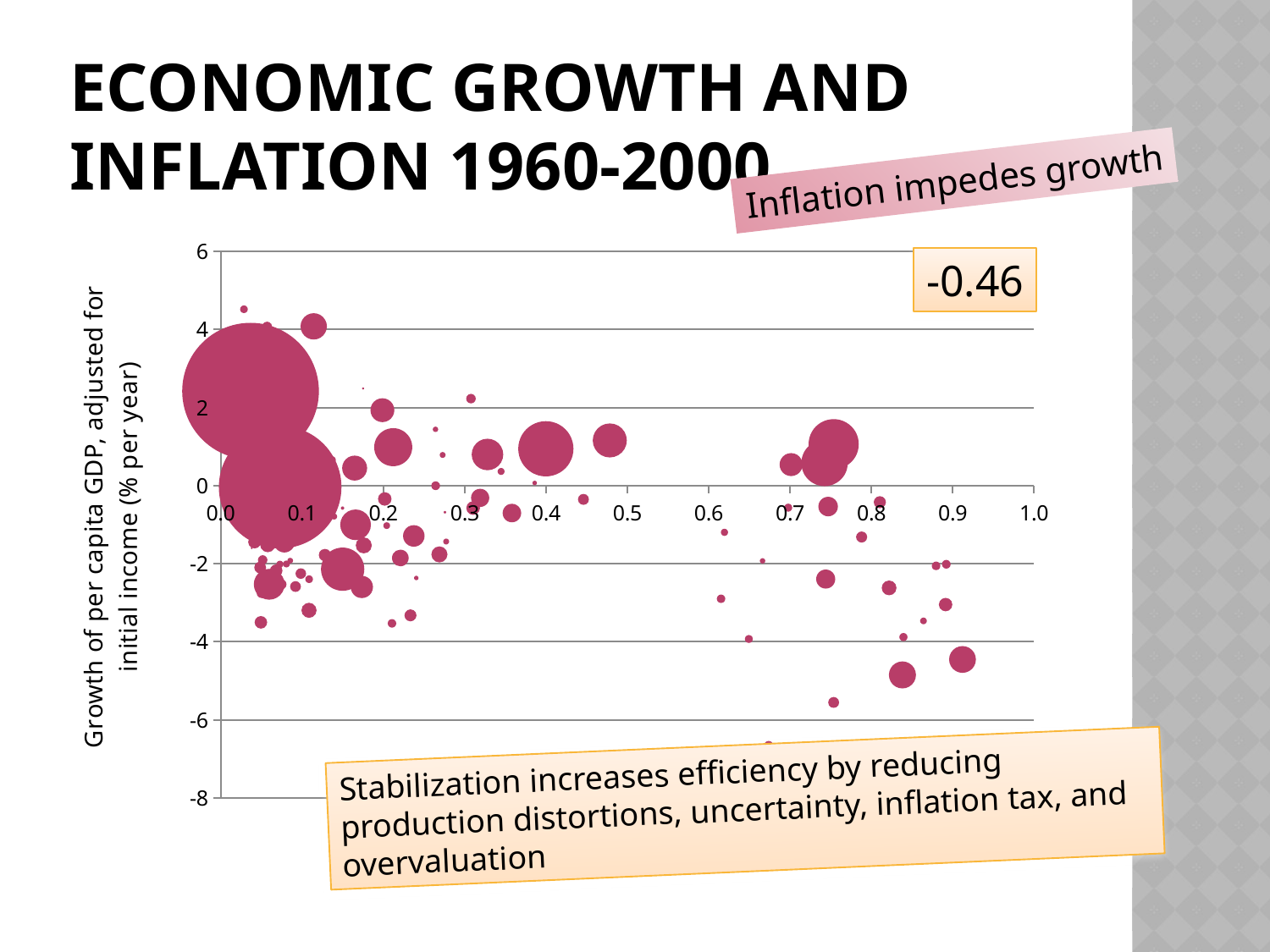
What correlation value is displayed in the box at the top right of the chart? -0.46 As the values along the x axis increase from 0.0 to 1.0, do the plotted growth values generally rise or fall? fall What is the label of the vertical axis of the chart? Growth of per capita GDP, adjusted for initial income (% per year) What kind of chart is shown on the slide? bubble chart